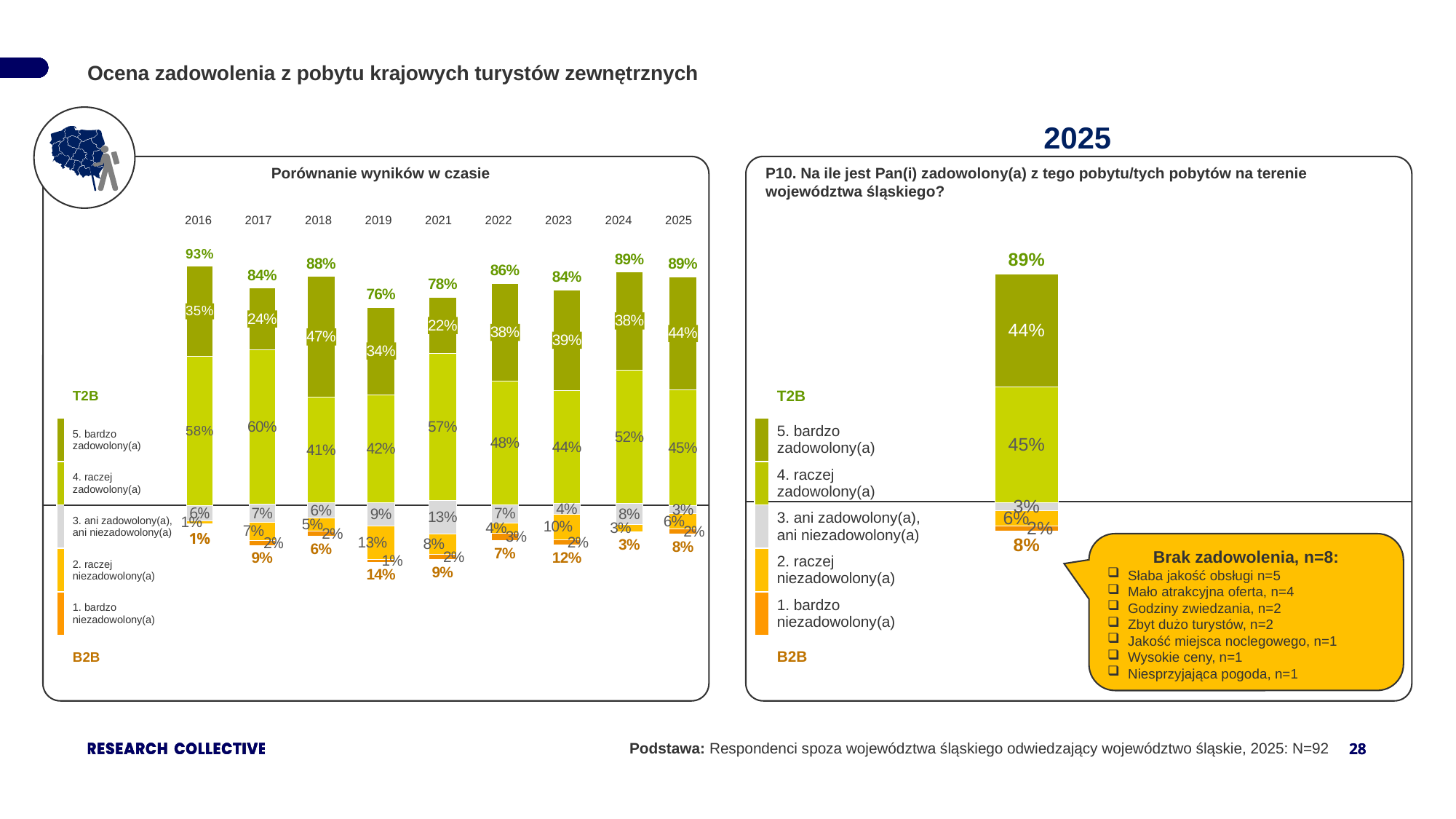
In the left chart 'Porównanie wyników w czasie', what is the T2B value for 2016? 93% In the right chart for 2025, what is the value for '5. bardzo zadowolony(a)'? 44% In the left chart 'Porównanie wyników w czasie', which year has the larger value for '5. bardzo zadowolony(a)': 2017 or 2018? 2018 In the left chart 'Porównanie wyników w czasie', what is the B2B value for 2019? 14% In the right chart for 2025, what is the B2B value? 8% In the left chart 'Porównanie wyników w czasie', what is the difference between the T2B value for 2016 and the T2B value for 2019? 17 percentage points In the left chart 'Porównanie wyników w czasie', how many years are shown on the x axis? 9 In the left chart 'Porównanie wyników w czasie', how many response categories does the legend list? 5 What kind of chart is the left chart 'Porównanie wyników w czasie'? Stacked bar chart In the left chart 'Porównanie wyników w czasie', which year has the lowest T2B value? 2019 In the left chart 'Porównanie wyników w czasie', which year has the highest T2B value? 2016 In the left chart 'Porównanie wyników w czasie', what is the value for '4. raczej zadowolony(a)' in 2017? 60%